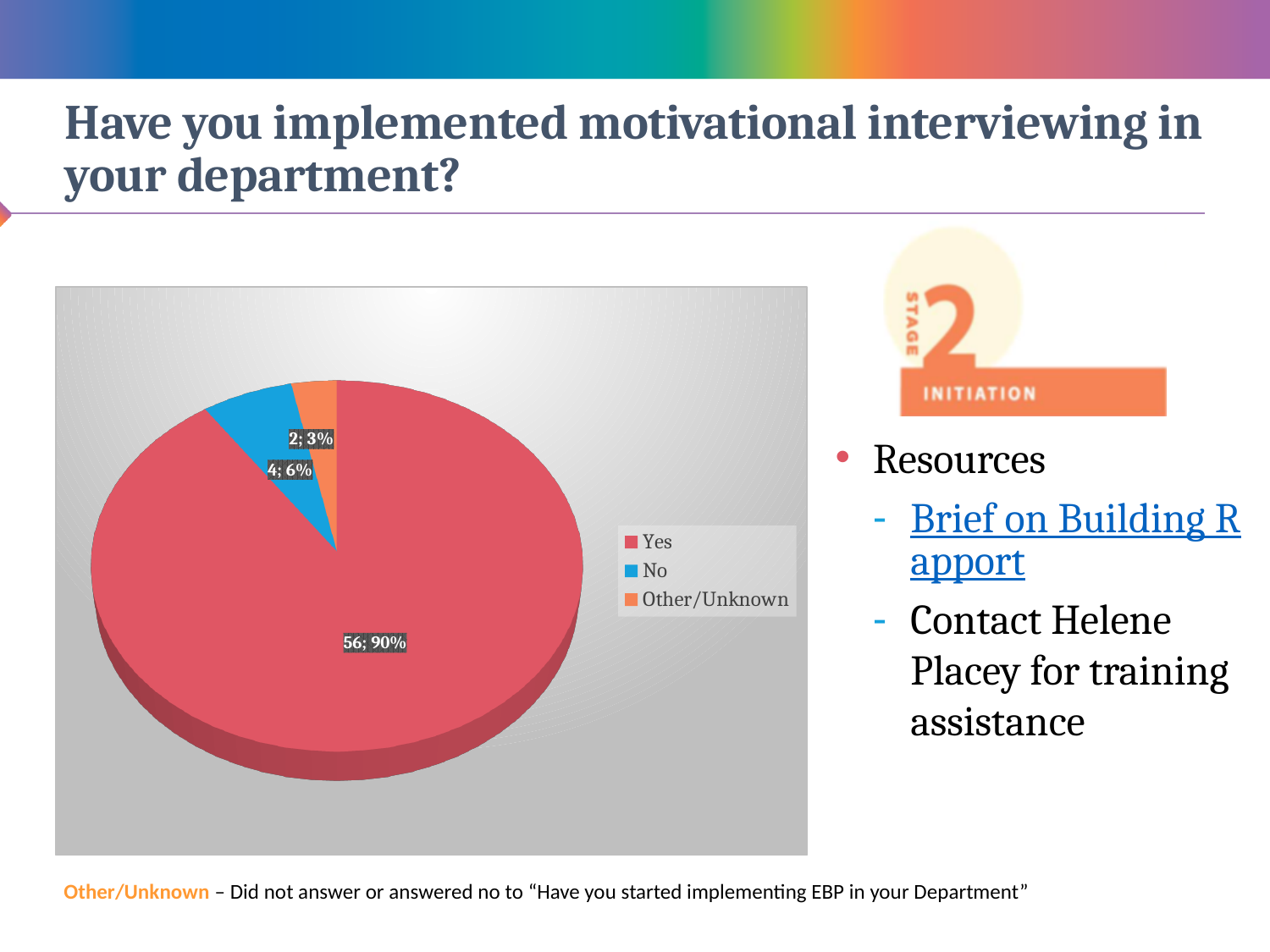
What is the count for the Yes slice? 56 Which category has the largest slice? Yes What is the count for the Other/Unknown slice? 2 What is the difference in count between the Yes and No slices? 52 Which colour represents the No slice in the legend? blue What share of the pie does the Other/Unknown slice represent? 3% How many slices does the pie chart have? 3 What share of the pie does the Yes slice represent? 90% Which category has the smallest slice? Other/Unknown What is the count for the No slice? 4 What share of the pie does the No slice represent? 6% What kind of chart is shown on the slide? pie chart